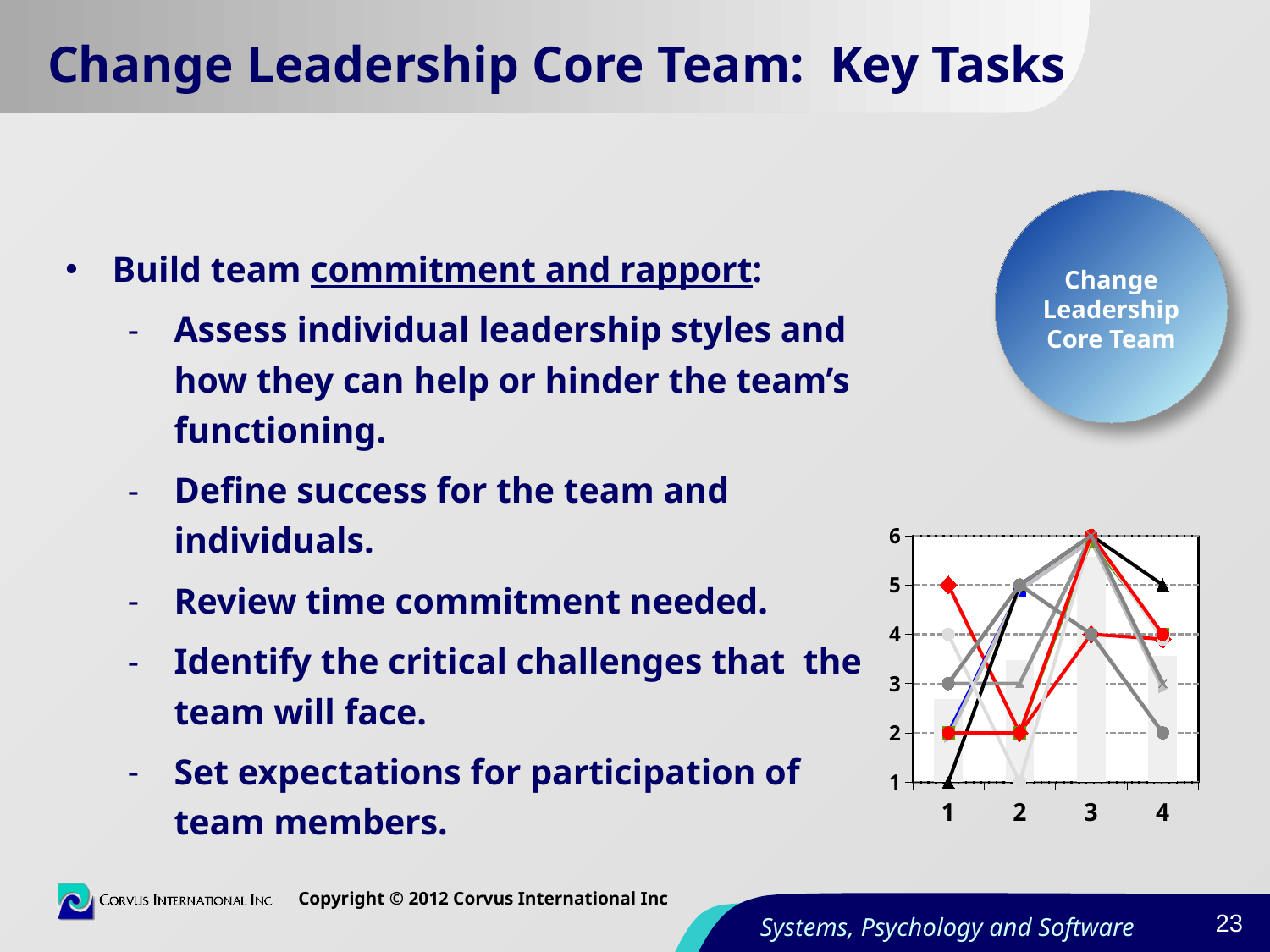
Does the chart include a legend identifying its series? No What is the highest value reached by any line at category 3? 6 What is the highest value labelled on the chart's y axis? 6 At which x-axis category do the lines reach the top value of 6? 3 How many categories are shown on the x axis of the chart? 4 What is the lowest value reached by any line at category 1? 1